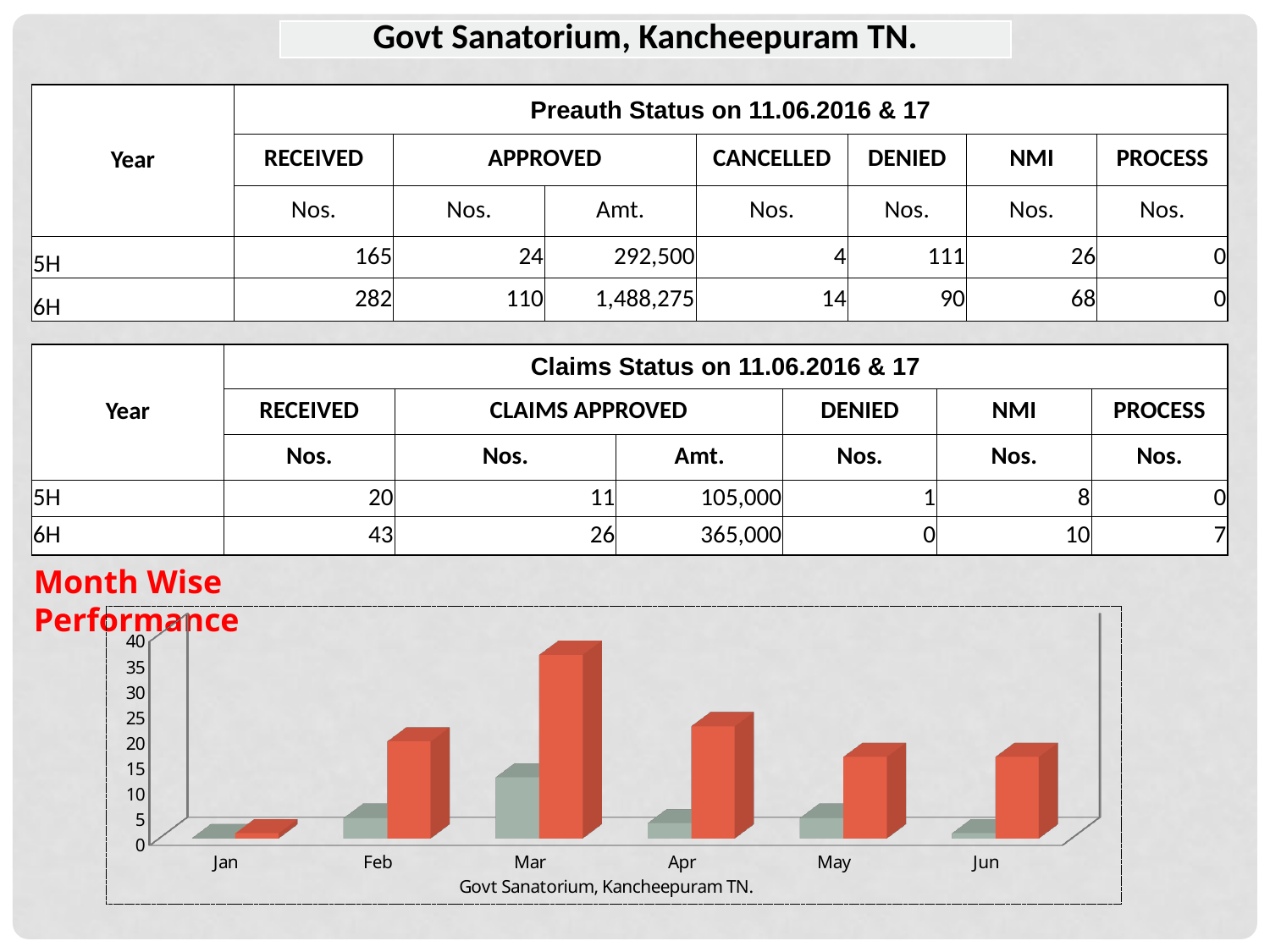
In the Month Wise Performance chart, which is larger, the red bar for Mar or the red bar for Apr? Mar In the Month Wise Performance chart, is the red bar for Mar greater or less than 30? greater In the Month Wise Performance chart, is the grey bar for Feb greater or less than 10? less What text appears as the axis title below the months in the Month Wise Performance chart? Govt Sanatorium, Kancheepuram TN. In the Month Wise Performance chart, is the red bar for Jan greater or less than 5? less In the Month Wise Performance chart, which month has the tallest red bar? Mar In the Month Wise Performance chart, which month has the shortest red bar? Jan In the Month Wise Performance chart, which month has the tallest grey bar? Mar How many months are shown on the x axis of the Month Wise Performance chart? 6 What kind of chart is shown under the heading "Month Wise Performance"? bar chart